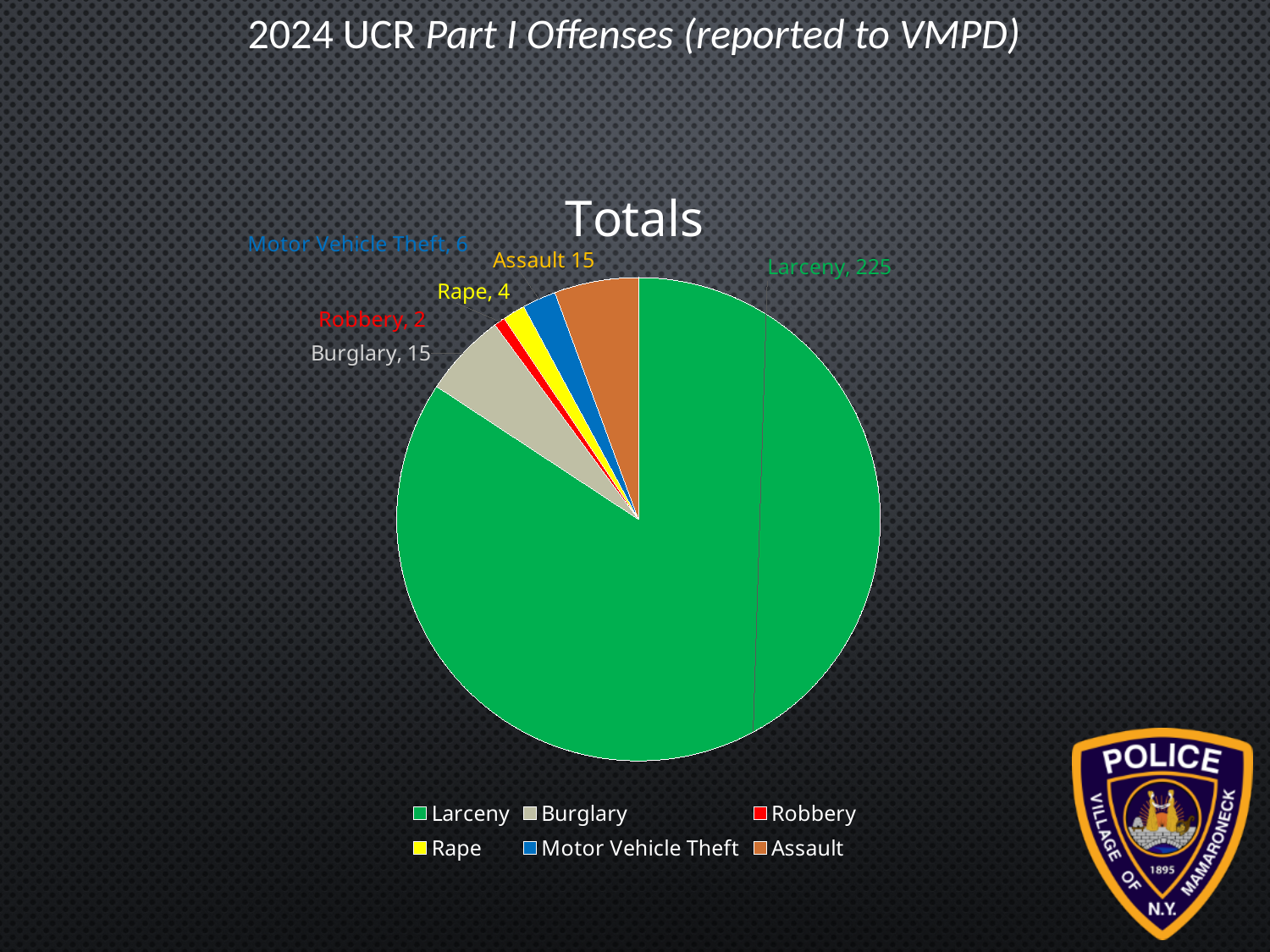
Which is larger, the value for Motor Vehicle Theft or the value for Rape? Motor Vehicle Theft What is the sum of all the values shown in the pie chart? 267 What is the value for Rape in the pie chart? 4 How many categories are shown in the pie chart? 6 What is the value for Burglary in the pie chart? 15 Which category has the smallest slice of the pie? Robbery What is the title shown above the pie chart? Totals Which category has the largest slice of the pie? Larceny What type of chart is shown on the slide? Pie chart What is the value for Larceny in the pie chart? 225 What is the difference between the Larceny value and the Burglary value? 210 What is the value for Motor Vehicle Theft in the pie chart? 6